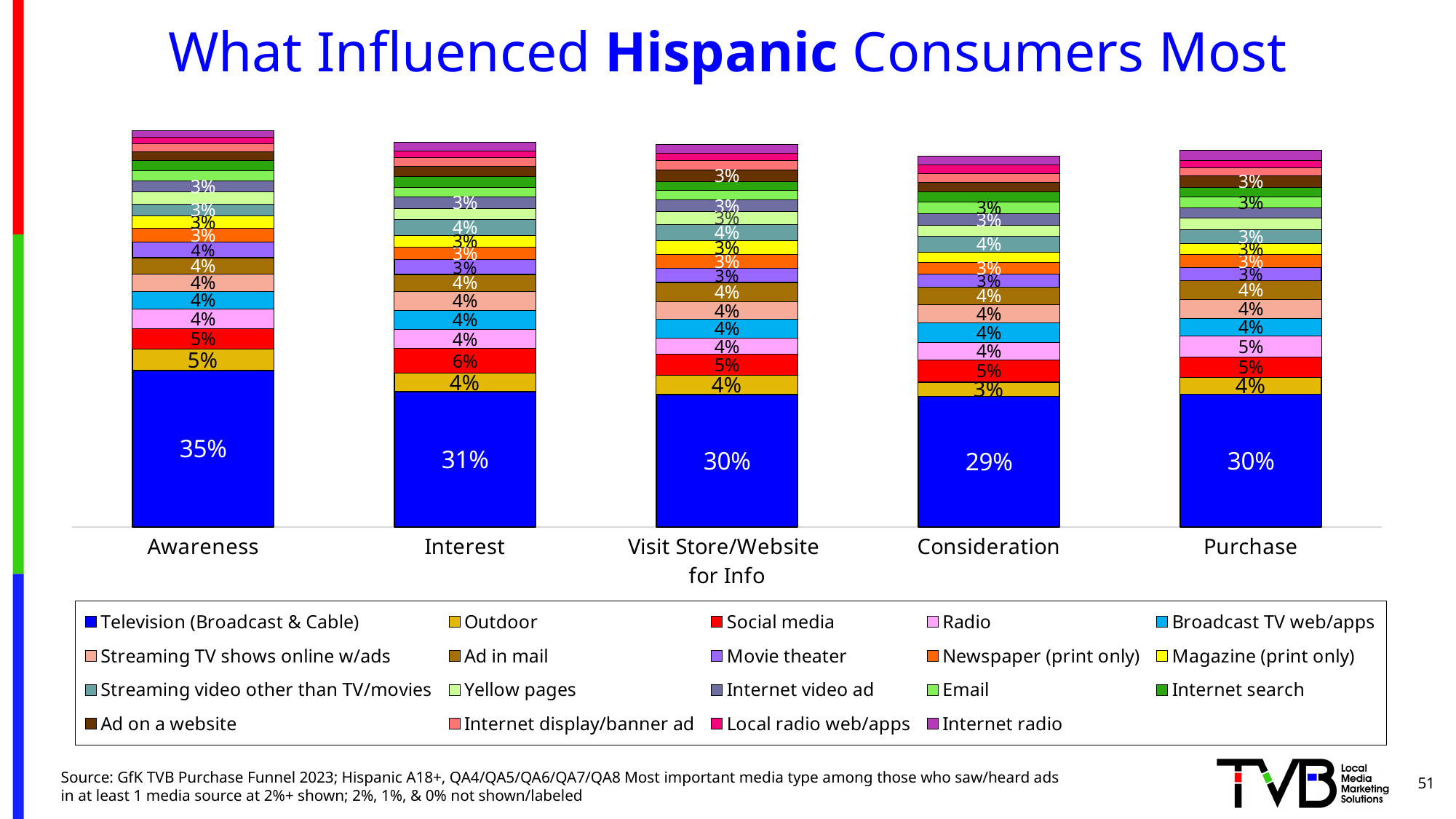
What is the Radio value for Purchase? 5% Which funnel stage has the highest Television (Broadcast & Cable) value? Awareness What is the Social media value for Interest? 6% What type of chart is shown on the slide? Stacked bar chart What is the Outdoor value for Awareness? 5% Which funnel stage has the lowest Television (Broadcast & Cable) value? Consideration In the Interest bar, which is larger: Social media or Outdoor? Social media How much higher is the Television (Broadcast & Cable) value for Awareness than for Interest? 4 percentage points How many funnel stages (categories) are shown on the x axis? 5 How many media types does the legend list? 19 What is the Television (Broadcast & Cable) value for Consideration? 29% What percentage does Television (Broadcast & Cable) account for in the Awareness bar? 35%